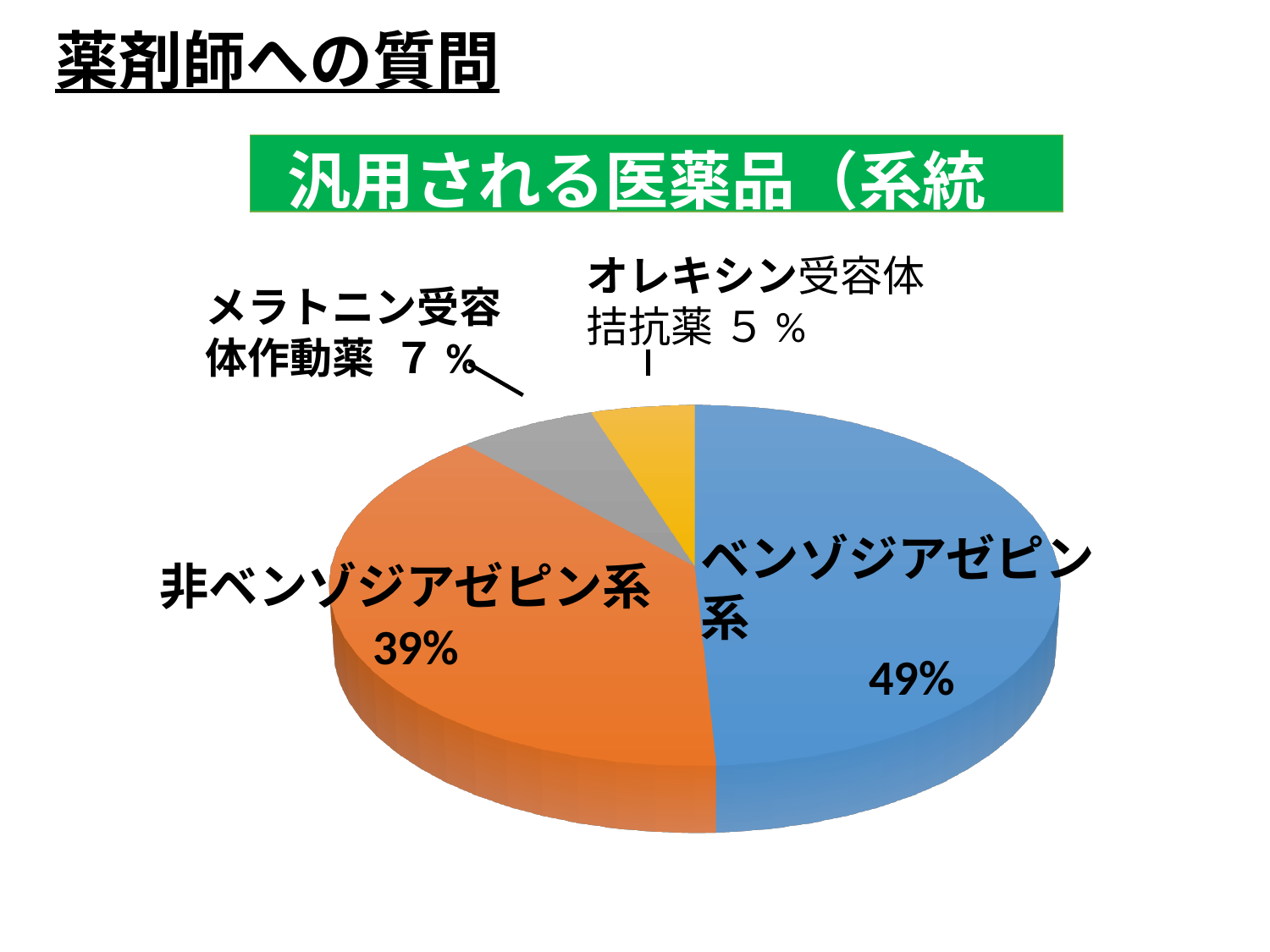
How many categories are shown in the pie chart? 4 What percentage of the pie chart is 非ベンゾジアゼピン系? 39% What percentage of the pie chart is ベンゾジアゼピン系? 49% What percentage does オレキシン受容体拮抗薬 account for in the pie chart? 5% Which category has the smallest slice of the pie chart? オレキシン受容体拮抗薬 What type of chart is shown on the slide? Pie chart What percentage does メラトニン受容体作動薬 account for in the pie chart? 7% What is the combined share of ベンゾジアゼピン系 and 非ベンゾジアゼピン系? 88% What colour is the slice for 非ベンゾジアゼピン系? Orange Which category has the largest slice of the pie chart? ベンゾジアゼピン系 Which is larger, the share for メラトニン受容体作動薬 or the share for オレキシン受容体拮抗薬? メラトニン受容体作動薬 What is the difference in percentage points between ベンゾジアゼピン系 and 非ベンゾジアゼピン系? 10 percentage points